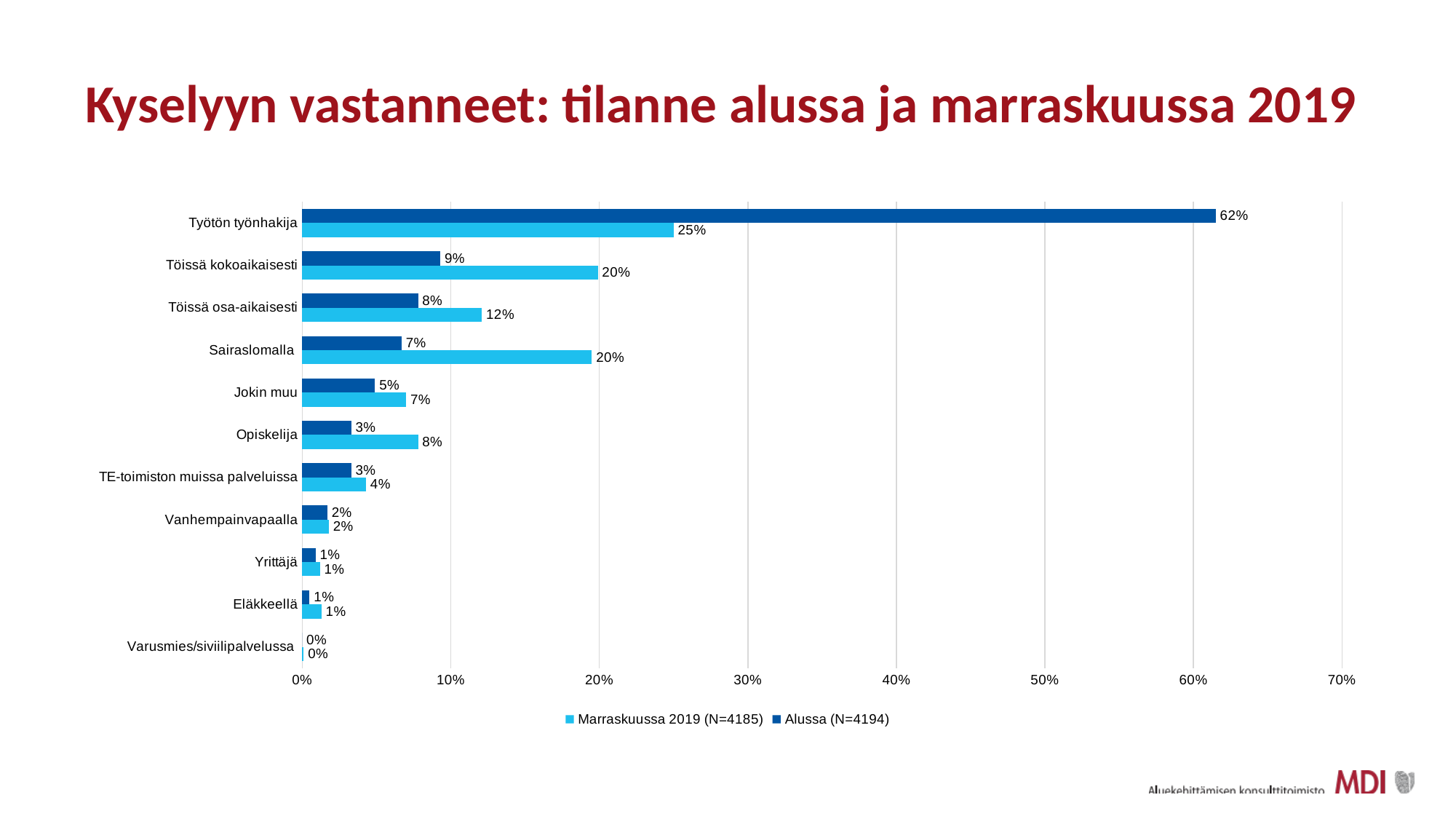
What kind of chart is shown on the slide? Bar chart What is the difference between the Alussa (N=4194) and Marraskuussa 2019 (N=4185) values for Työtön työnhakija? 37% Which category has the highest Alussa (N=4194) value? Työtön työnhakija What is the Marraskuussa 2019 (N=4185) value for Töissä osa-aikaisesti? 12% Which category has the lowest Marraskuussa 2019 (N=4185) value? Varusmies/siviilipalvelussa How many series does the legend list? 2 What is the title of the slide? Kyselyyn vastanneet: tilanne alussa ja marraskuussa 2019 What is the Marraskuussa 2019 (N=4185) value for Sairaslomalla? 20% Is the Alussa (N=4194) value for Työtön työnhakija greater or less than 60%? greater For Töissä kokoaikaisesti, which series has the larger value: Alussa (N=4194) or Marraskuussa 2019 (N=4185)? Marraskuussa 2019 (N=4185) How many categories are shown on the chart? 11 What is the Alussa (N=4194) value for Työtön työnhakija? 62%